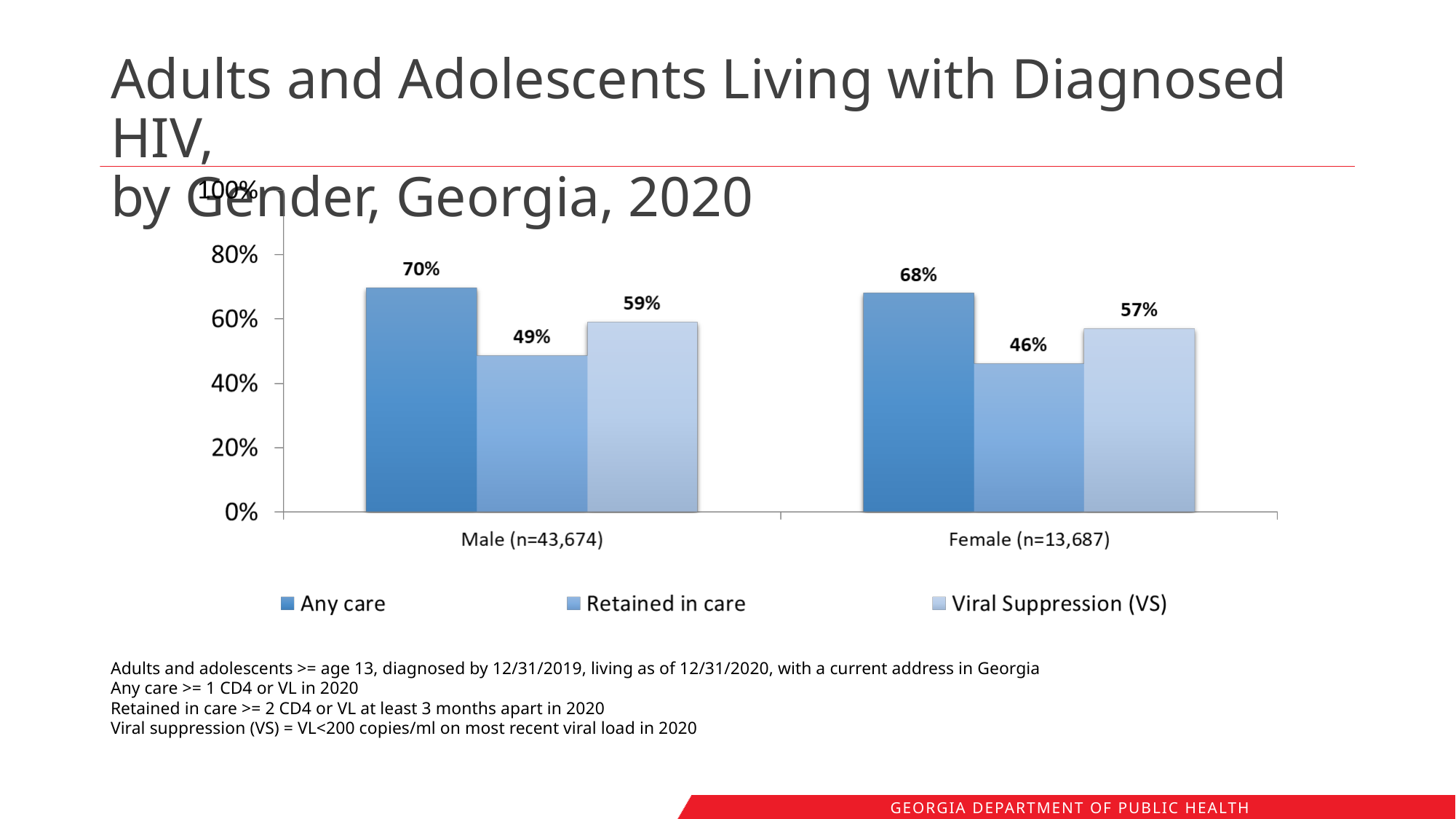
What is the difference between any care and retained in care for males? 21% What percentage of males received any care? 70% How many series does the legend list? 3 Which series has the lowest value for females? Retained in care Which series has the highest value for males? Any care Which gender has the higher value for retained in care? Male (n=43,674) What is the viral suppression value for females? 57% What kind of chart is shown on the slide? Bar chart What is the sample size shown for females in the x-axis label? n=13,687 How many gender categories are shown on the x axis? 2 What percentage of females were retained in care? 46% What is the difference between the any care values for males and females? 2%